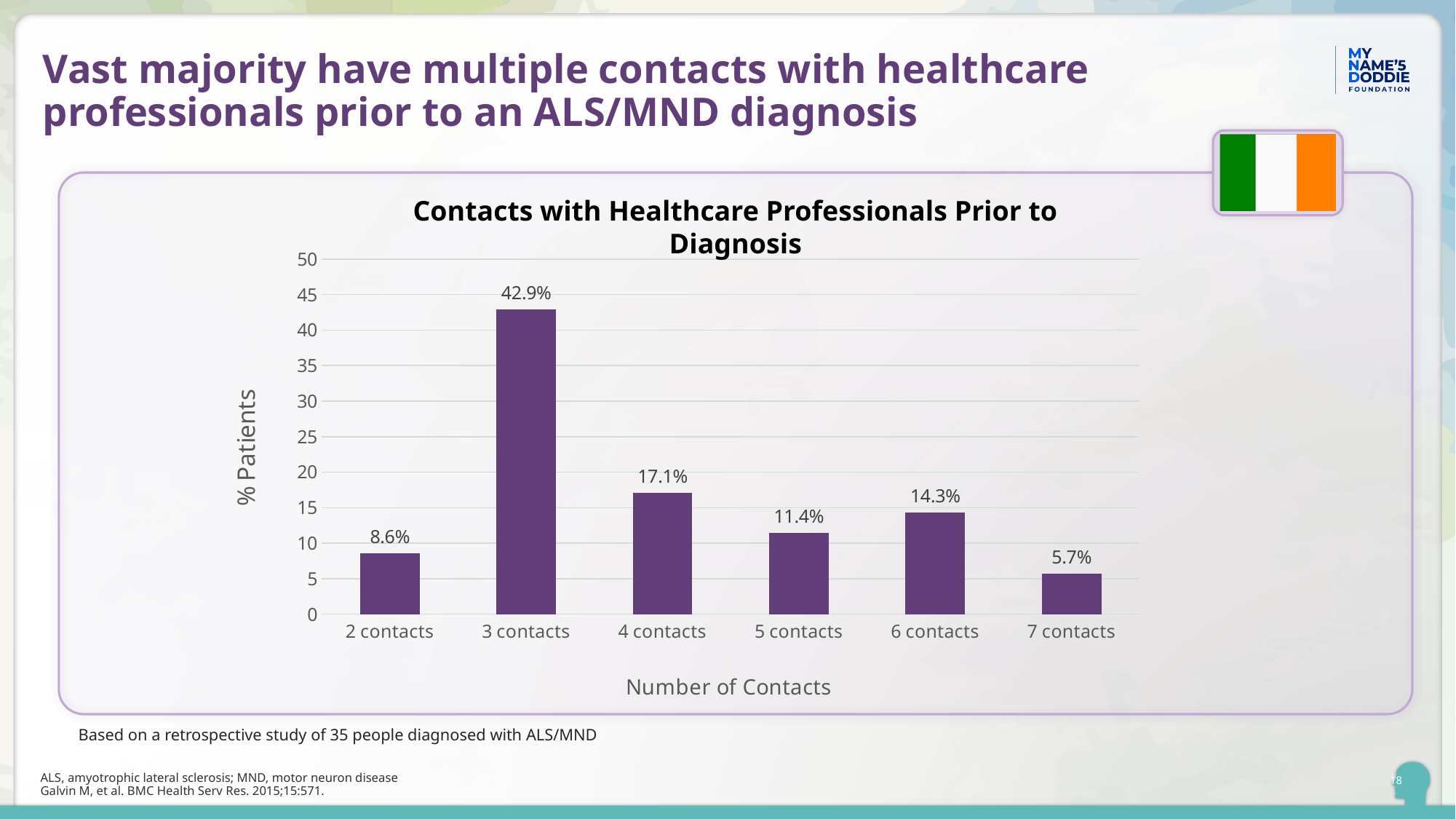
What percentage of patients had 7 contacts? 5.7% What is the difference between the values for 3 contacts and 4 contacts? 25.8% Is the value for 4 contacts greater or less than 15? greater What is the label of the y axis? % Patients Which is larger, the value for 2 contacts or the value for 6 contacts? 6 contacts What type of chart is shown on the slide? Bar chart What is the title of the chart? Contacts with Healthcare Professionals Prior to Diagnosis Which number of contacts has the highest percentage of patients? 3 contacts What percentage of patients had 3 contacts with healthcare professionals prior to diagnosis? 42.9% Which number of contacts has the lowest percentage of patients? 7 contacts How many categories are shown on the x axis? 6 What is the value shown for 5 contacts? 11.4%